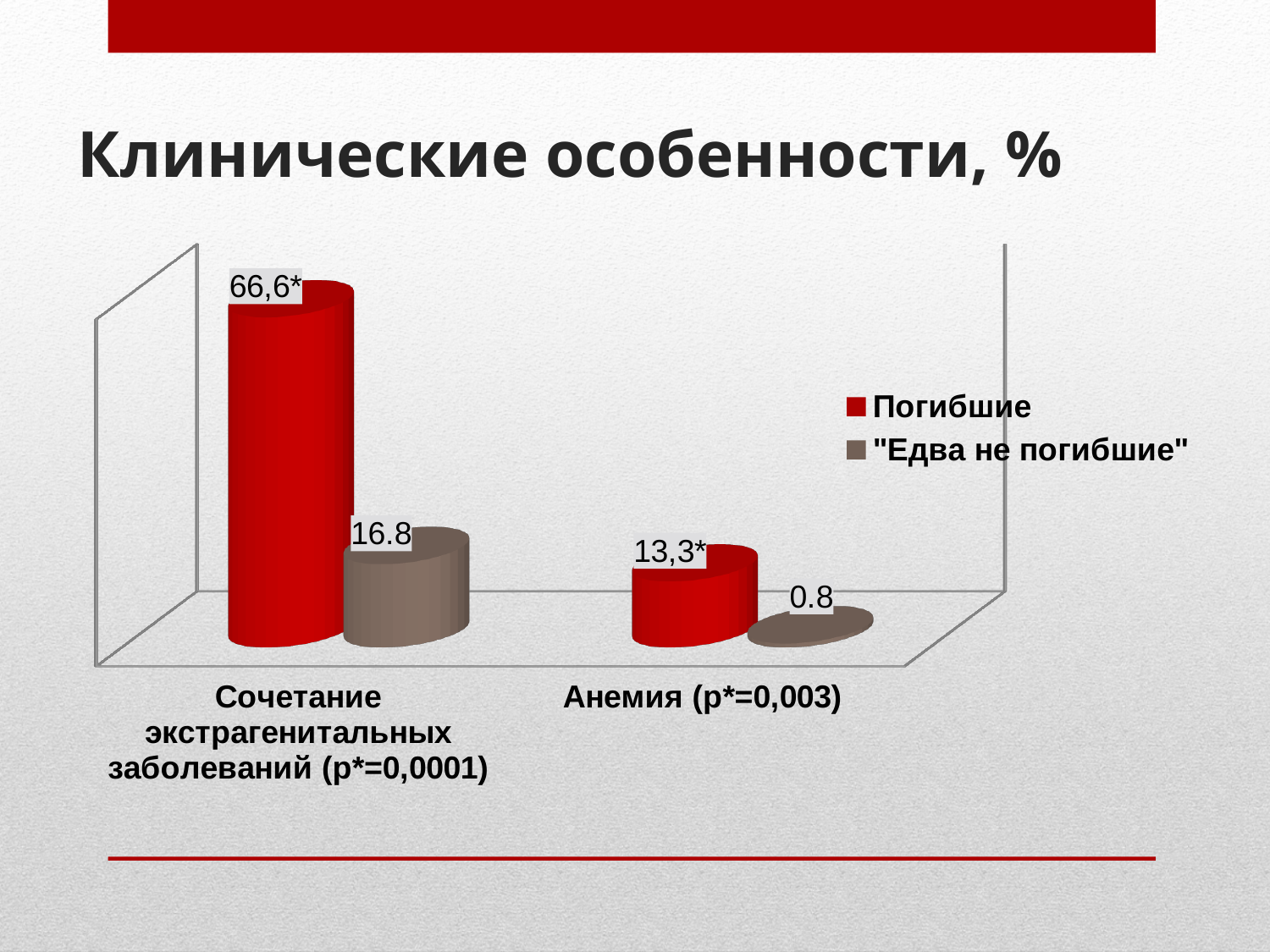
Which category has the lowest value for the "Едва не погибшие" series? Анемия (p*=0,003) What kind of chart is shown on the slide? Bar chart Which category has the highest value for the Погибшие series? Сочетание экстрагенитальных заболеваний (p*=0,0001) How many categories are shown on the x axis? 2 What is the value for Погибшие in the category Анемия (p*=0,003)? 13,3* In the category Анемия (p*=0,003), which series has the larger value, Погибшие or "Едва не погибшие"? Погибшие What is the title of the slide? Клинические особенности, % How many series does the legend list? 2 What is the value for Погибшие in the category Сочетание экстрагенитальных заболеваний (p*=0,0001)? 66,6* What is the value for "Едва не погибшие" in the category Анемия (p*=0,003)? 0.8 What is the value for "Едва не погибшие" in the category Сочетание экстрагенитальных заболеваний (p*=0,0001)? 16.8 Which series is shown in red? Погибшие